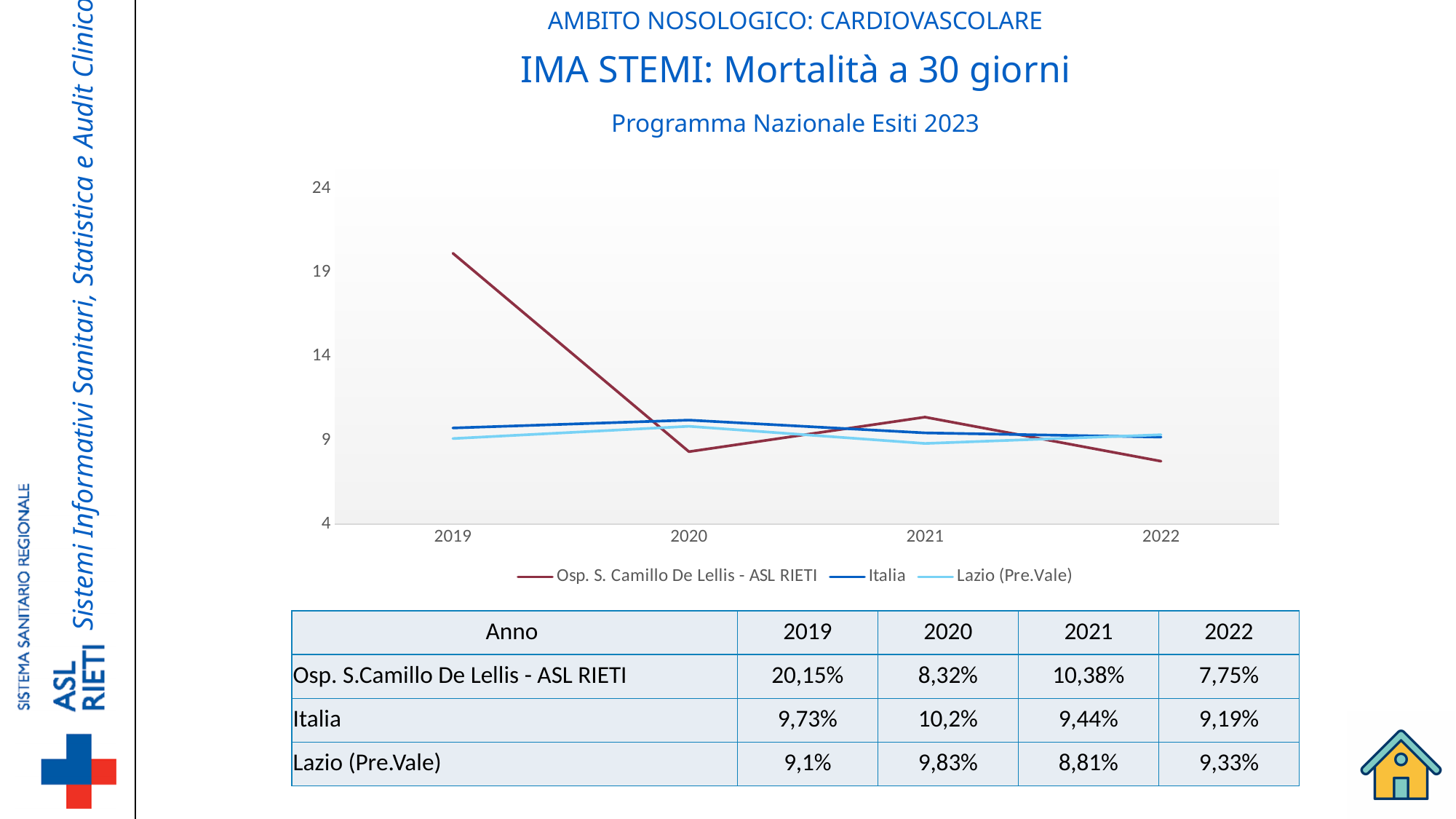
In 2020, which is larger: the value for Italia or the value for Osp. S.Camillo De Lellis - ASL RIETI? Italia In which year is the value for Osp. S.Camillo De Lellis - ASL RIETI highest? 2019 What is the value for Osp. S.Camillo De Lellis - ASL RIETI in 2019? 20,15% What is the value for Lazio (Pre.Vale) in 2021? 8,81% Does the value for Italia rise or fall from 2020 to 2022? fall In which year is the value for Osp. S.Camillo De Lellis - ASL RIETI lowest? 2022 How many series does the chart legend list? 3 What is the value for Italia in 2020? 10,2% Is the value for Osp. S. Camillo De Lellis - ASL RIETI in 2019 greater or less than 19? greater What type of chart is shown on the slide? line chart How many years are plotted along the x axis of the chart? 4 What is the difference between the Osp. S.Camillo De Lellis - ASL RIETI values in 2019 and 2022? 12,4%